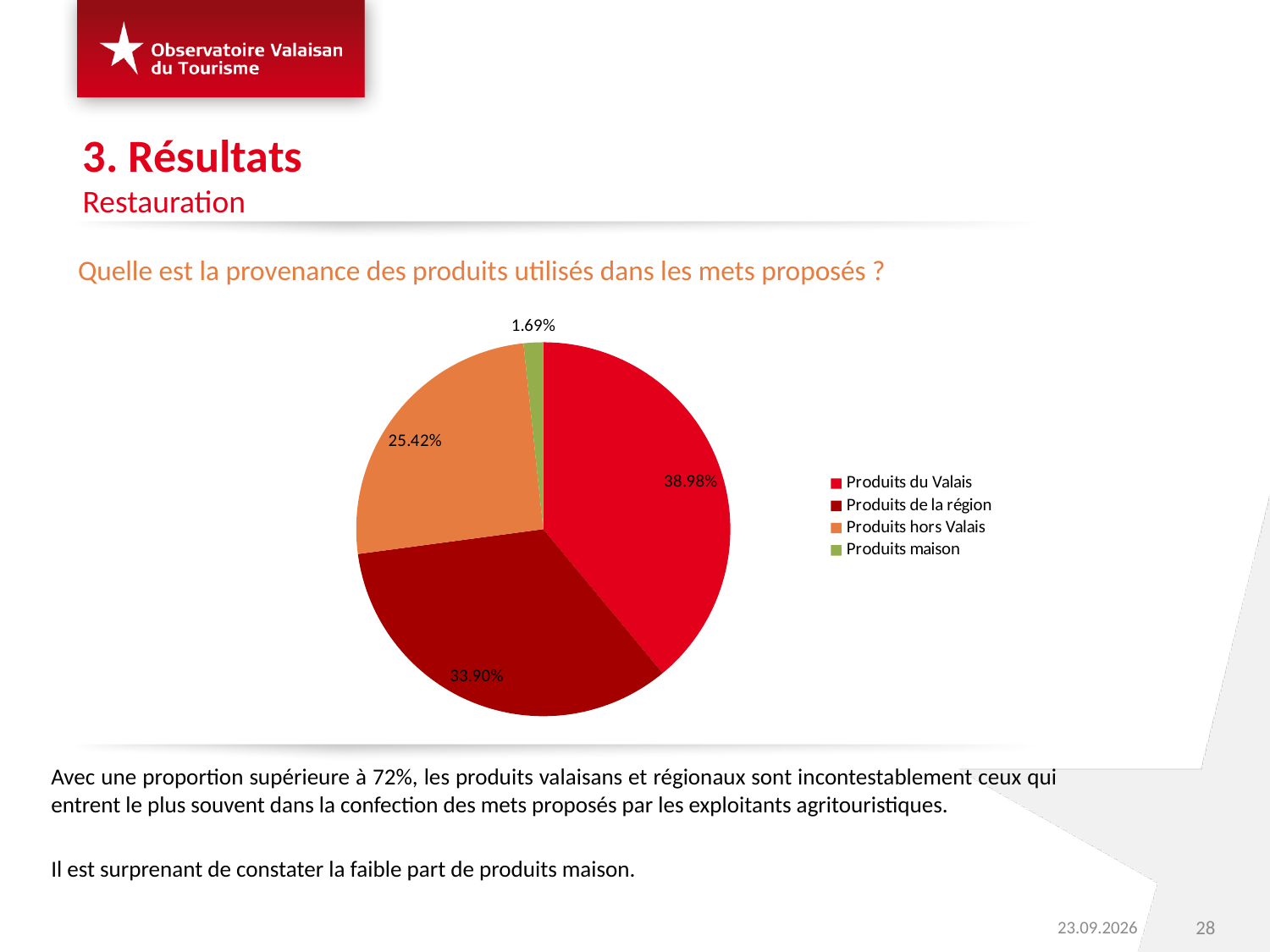
What kind of chart is shown on the slide? Pie chart What share of the pie is labelled for Produits de la région? 33.90% Which category has the largest slice of the pie? Produits du Valais What share of the pie is labelled for Produits hors Valais? 25.42% How many entries does the legend list? 4 Which is larger, the share for Produits hors Valais or the share for Produits de la région? Produits de la région What share of the pie is labelled for Produits du Valais? 38.98% How many slices does the pie chart have? 4 What share of the pie is labelled for Produits maison? 1.69% What colour is the slice for Produits maison? Green What is the difference in percentage points between Produits du Valais and Produits de la région? 5.08 Which category has the smallest slice of the pie? Produits maison